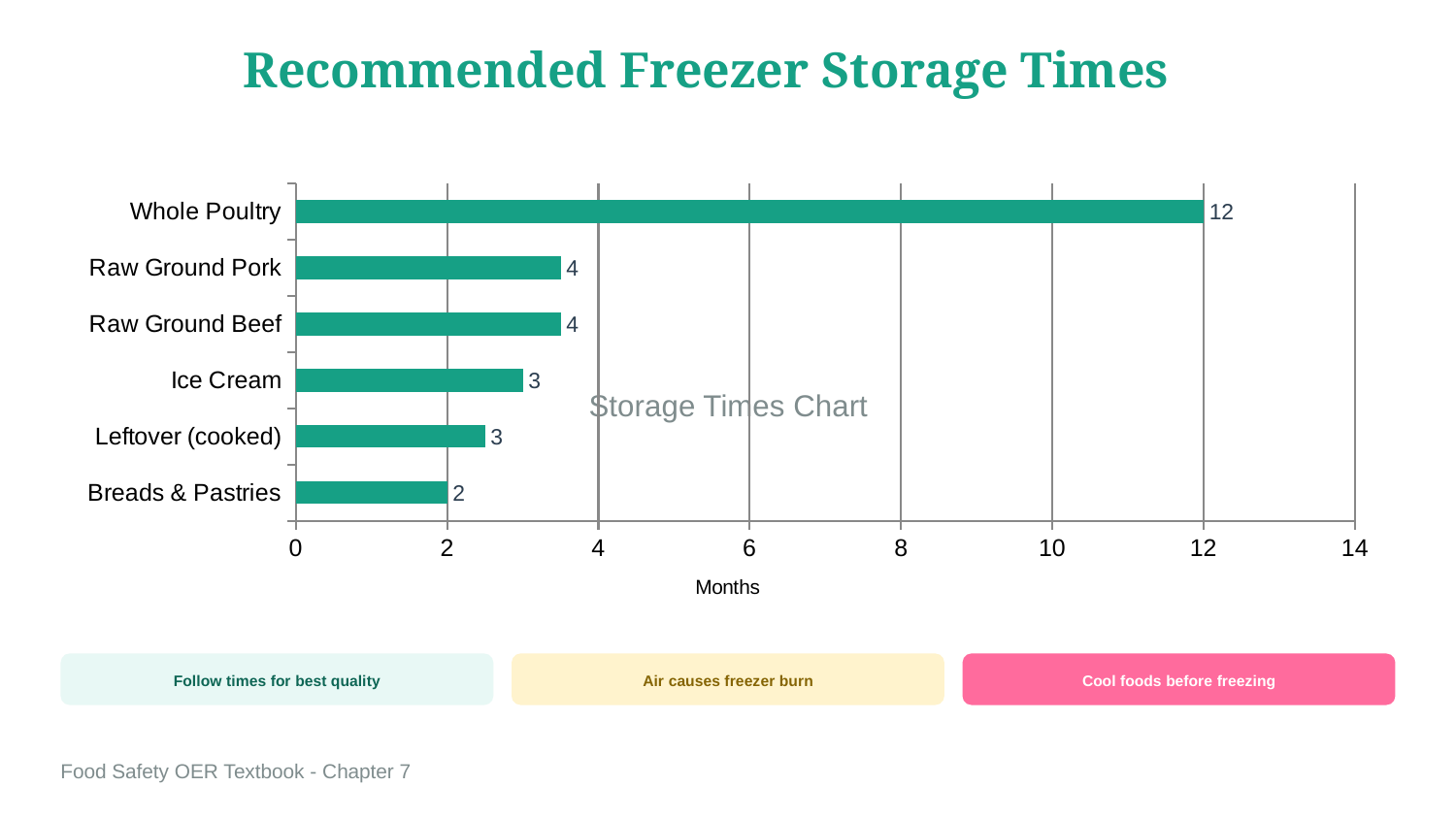
What value is shown for Raw Ground Beef? 4 What kind of chart is shown on the slide? Bar chart Which category has the shortest recommended freezer storage time? Breads & Pastries What value is shown for Breads & Pastries? 2 Which category has the longest recommended freezer storage time? Whole Poultry What value is shown for Ice Cream? 3 What is the label of the horizontal axis? Months Is the value for Whole Poultry greater or less than 10? greater Which has a larger value, Whole Poultry or Ice Cream? Whole Poultry What is the recommended freezer storage time for Whole Poultry? 12 How many food categories are shown in the chart? 6 What is the difference between the values for Whole Poultry and Raw Ground Pork? 8